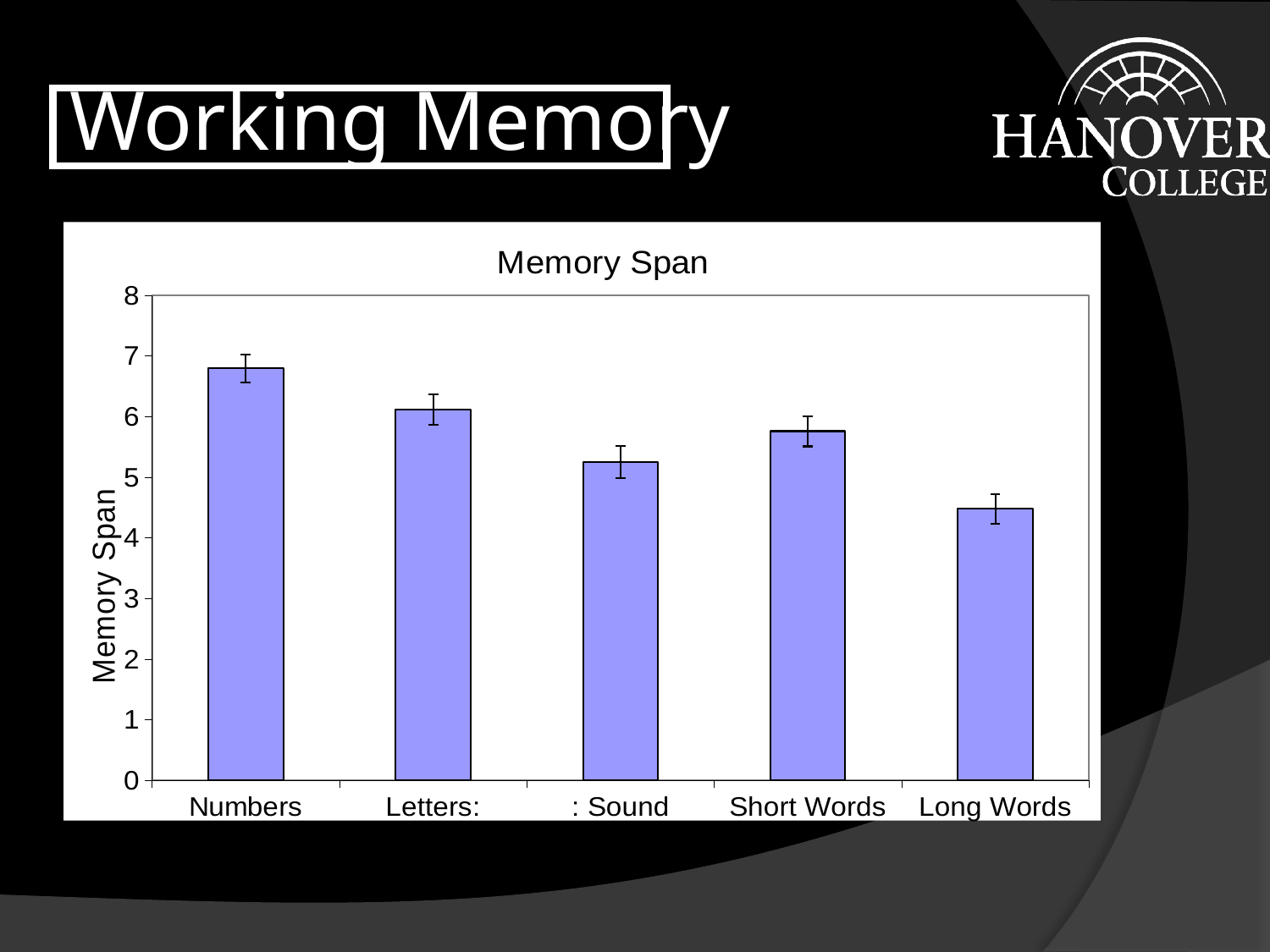
Is the memory span for Short Words greater or less than 5? greater What is the title of the chart? Memory Span What is the label on the vertical axis of the chart? Memory Span How many categories are plotted in the Memory Span chart? 5 Which category has the lowest memory span? Long Words Is the memory span for : Sound greater or less than 6? less What kind of chart is shown on the slide? bar chart Is the memory span for Long Words greater or less than 5? less Which has a larger memory span, Numbers or Letters:? Numbers Which category has the highest memory span? Numbers Which has a larger memory span, Short Words or : Sound? Short Words